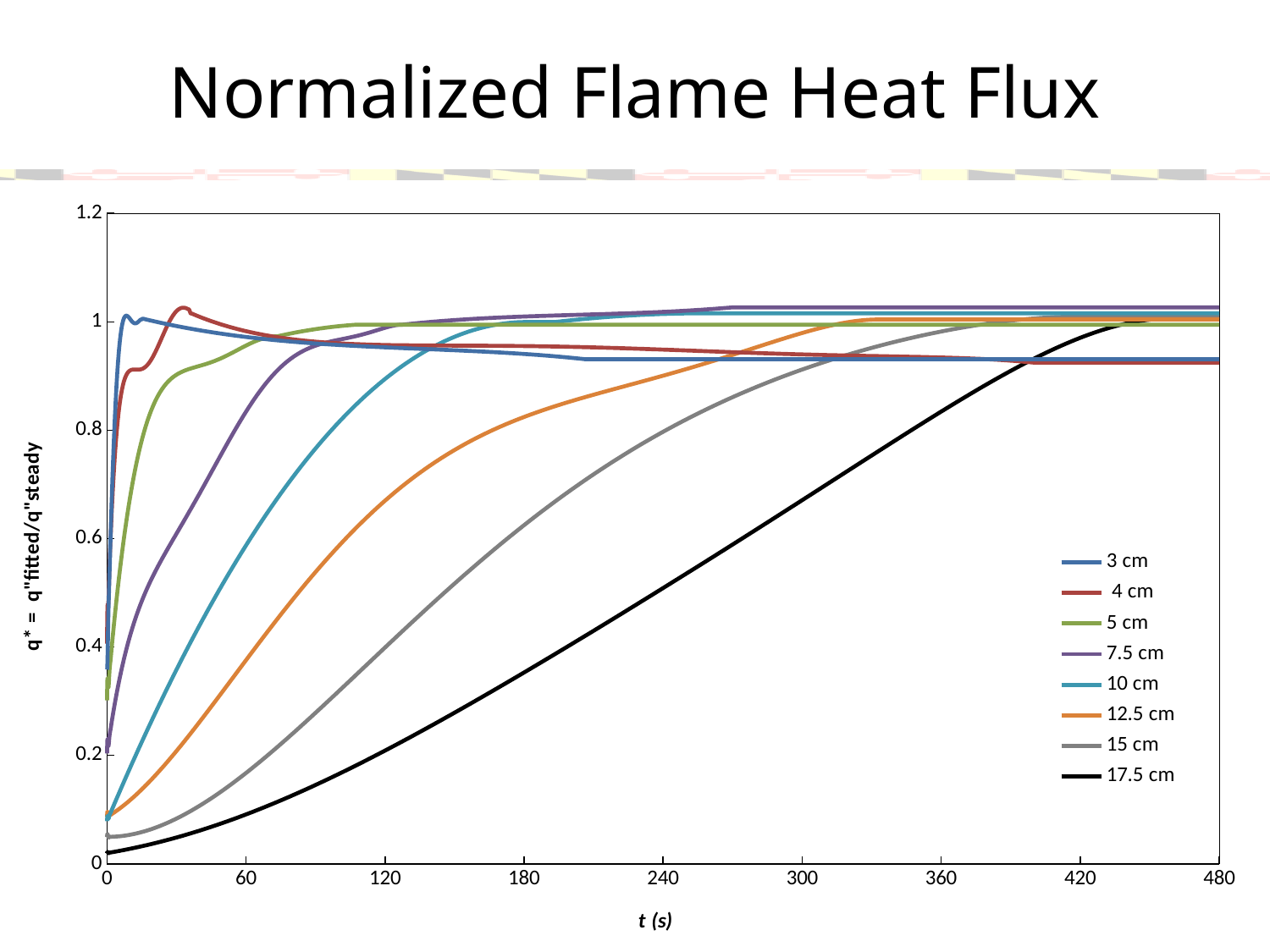
Is the value for the 12.5 cm series at t = 60 s greater or less than 0.2? greater At t = 300 s, which series has the larger value, 12.5 cm or 17.5 cm? 12.5 cm Is the value for the 17.5 cm series at t = 300 s greater or less than 0.6? greater Is the value for the 17.5 cm series at t = 180 s greater or less than 0.4? less Which series has the lowest value at t = 240 s? 17.5 cm What is the title of the chart? Normalized Flame Heat Flux How many series does the legend list? 8 At t = 120 s, which series has the larger value, 10 cm or 15 cm? 10 cm What is the label of the x axis? t (s) Which series has the highest value at t = 120 s? 5 cm Does the 17.5 cm series rise or fall as t increases from 0 to 480 s? rise What kind of chart is shown on the slide? line chart